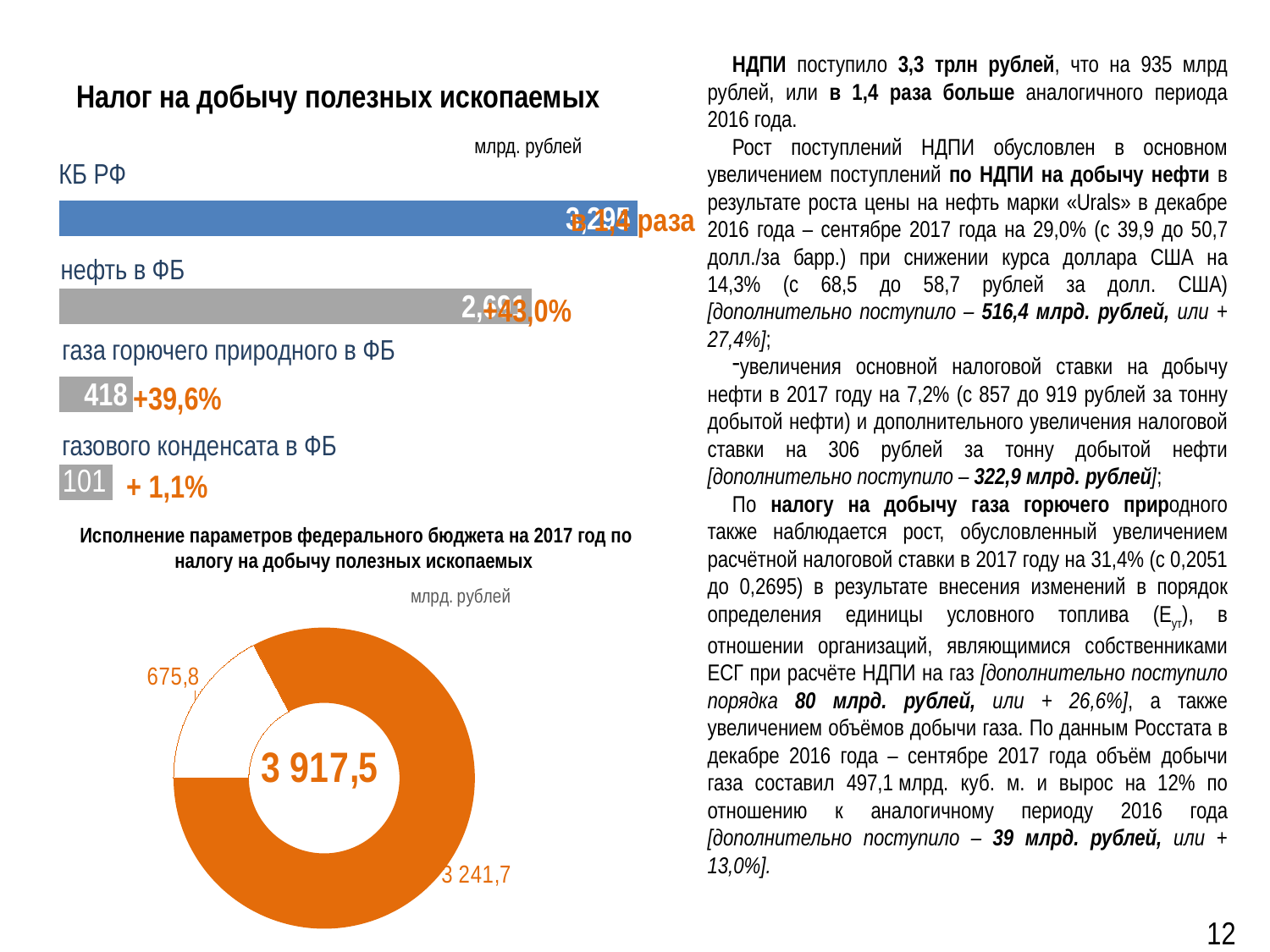
How many categories does the bar chart show? 4 In the bar chart, which category has the lowest value? газового конденсата в ФБ In the bar chart, what is the difference between the values for газа горючего природного в ФБ and газового конденсата в ФБ? 317 In the bar chart, what is the value for газового конденсата в ФБ? 101 In the doughnut chart titled 'Исполнение параметров федерального бюджета на 2017 год по налогу на добычу полезных ископаемых', what is the value of the smaller slice? 675,8 In the bar chart, which category has the highest value? КБ РФ In the doughnut chart titled 'Исполнение параметров федерального бюджета на 2017 год по налогу на добычу полезных ископаемых', what is the value of the larger slice? 3 241,7 In the bar chart, what is the value for газа горючего природного в ФБ? 418 In the bar chart, which is larger: газа горючего природного в ФБ or газового конденсата в ФБ? газа горючего природного в ФБ In the doughnut chart titled 'Исполнение параметров федерального бюджета на 2017 год по налогу на добычу полезных ископаемых', what is the total shown in the centre? 3 917,5 What kind of chart is the upper chart on the slide? bar chart In the bar chart, what growth percentage is shown next to газа горючего природного в ФБ? +39,6%